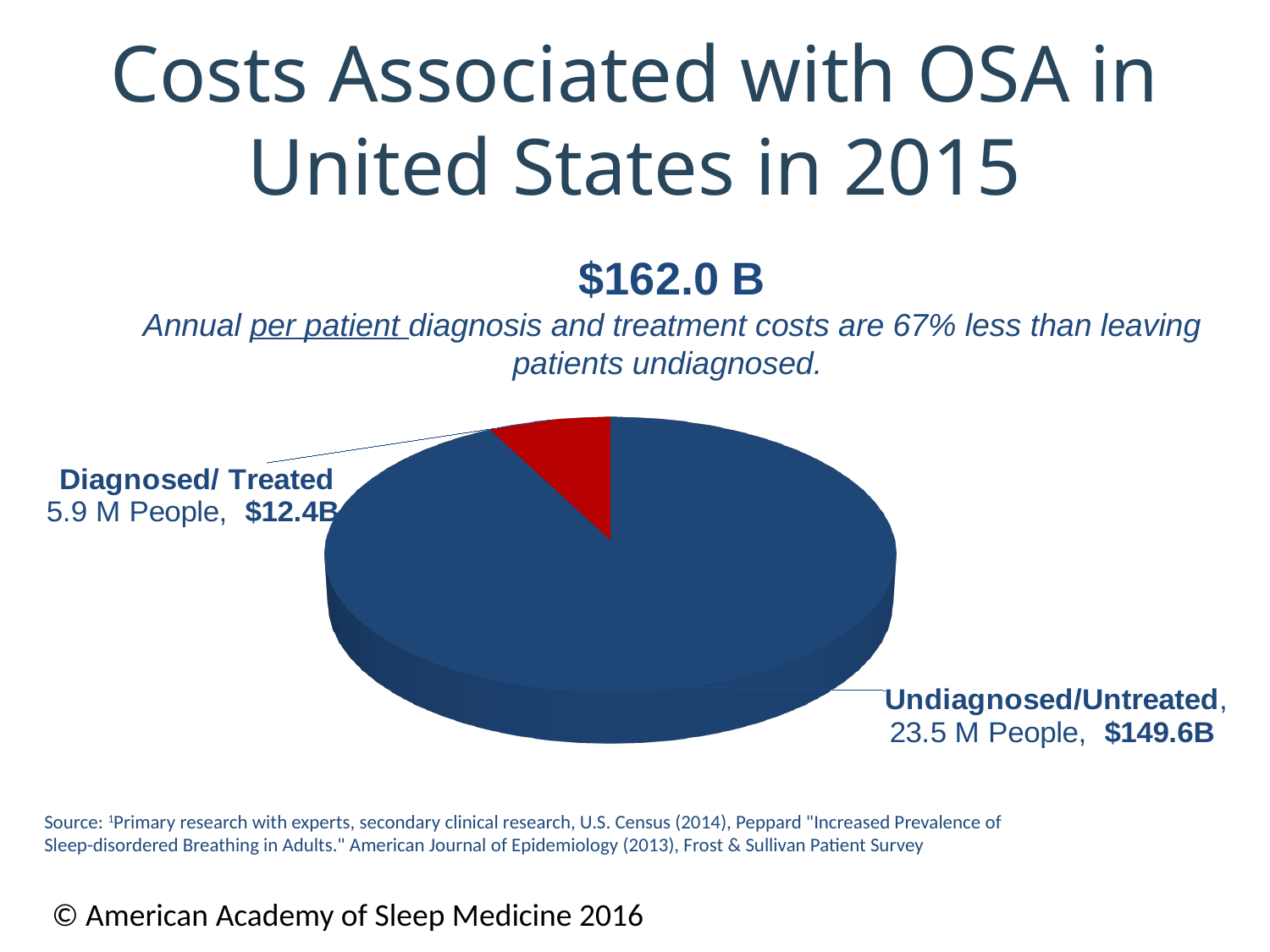
What type of chart is shown on the slide? Pie chart How many slices does the pie chart have? 2 How many people are in the Undiagnosed/Untreated group? 23.5 M People What is the difference in cost between the Undiagnosed/Untreated and Diagnosed/Treated slices? $137.2B Which slice of the pie chart is the smallest? Diagnosed/Treated What colour is the Diagnosed/Treated slice? Red Which is larger, the cost for Diagnosed/Treated or the cost for Undiagnosed/Untreated? Undiagnosed/Untreated What is the cost value shown for the Undiagnosed/Untreated slice? $149.6B How many people are in the Diagnosed/Treated group? 5.9 M People What is the total cost shown above the pie chart? $162.0 B Which slice of the pie chart is the largest? Undiagnosed/Untreated What is the cost value shown for the Diagnosed/Treated slice? $12.4B